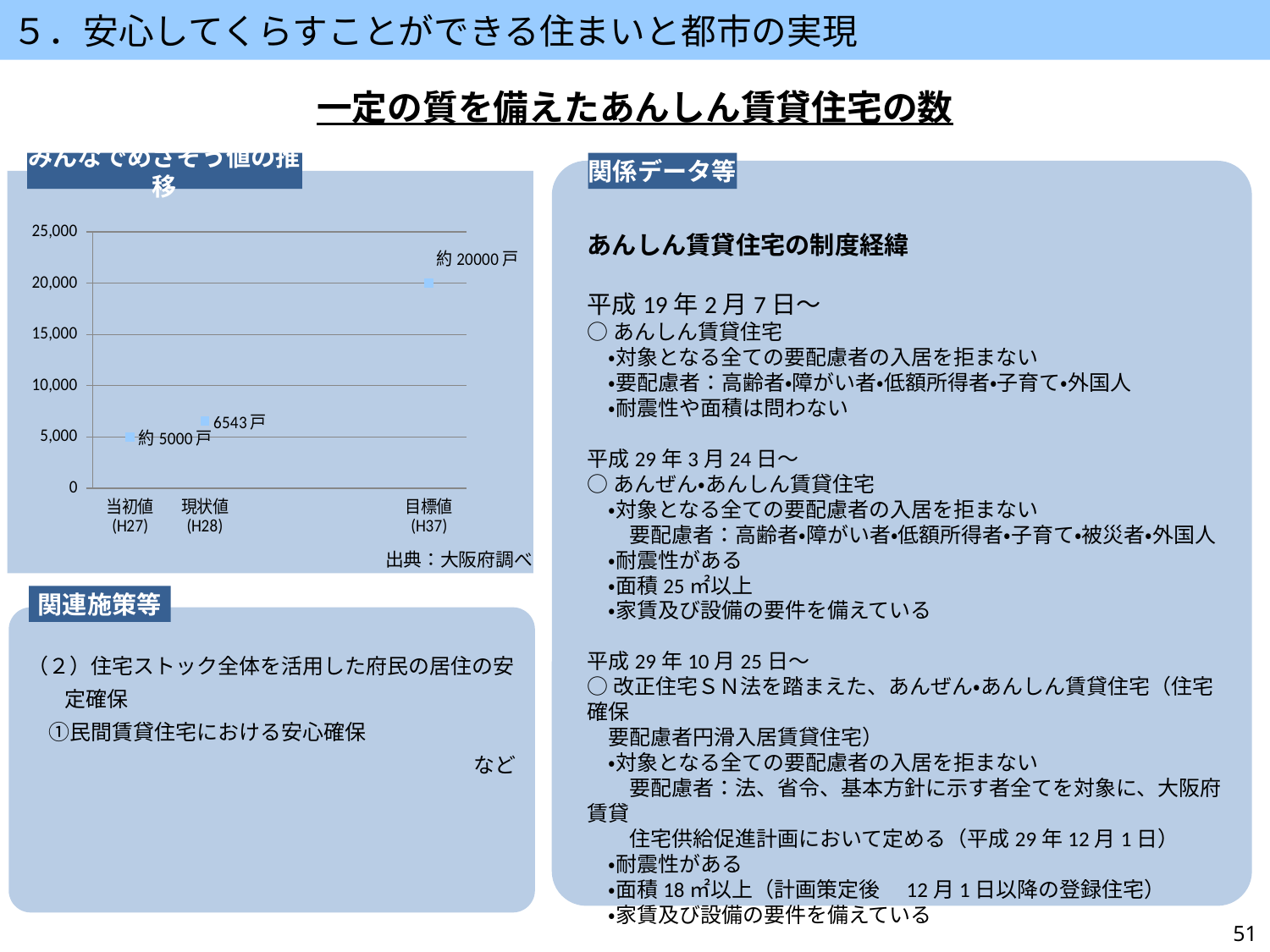
Which category has the highest value in the chart? 目標値 (H37) Do the values rise or fall from 当初値 (H27) to 目標値 (H37)? rise What is the title of the chart? みんなでめざそう値の推移 What is the value shown for 現状値 (H28) in the chart? 6543戸 What is the value shown for 目標値 (H37) in the chart? 約20000戸 How many data points are plotted in the chart? 3 Which category has the lowest value in the chart? 当初値 (H27) Is the value for 目標値 (H37) greater or less than 15,000? greater Is the value for 現状値 (H28) greater or less than 10,000? less Which is larger, the value for 現状値 (H28) or the value for 当初値 (H27)? 現状値 (H28) What is the source cited below the chart? 大阪府調べ What is the value shown for 当初値 (H27) in the chart? 約5000戸